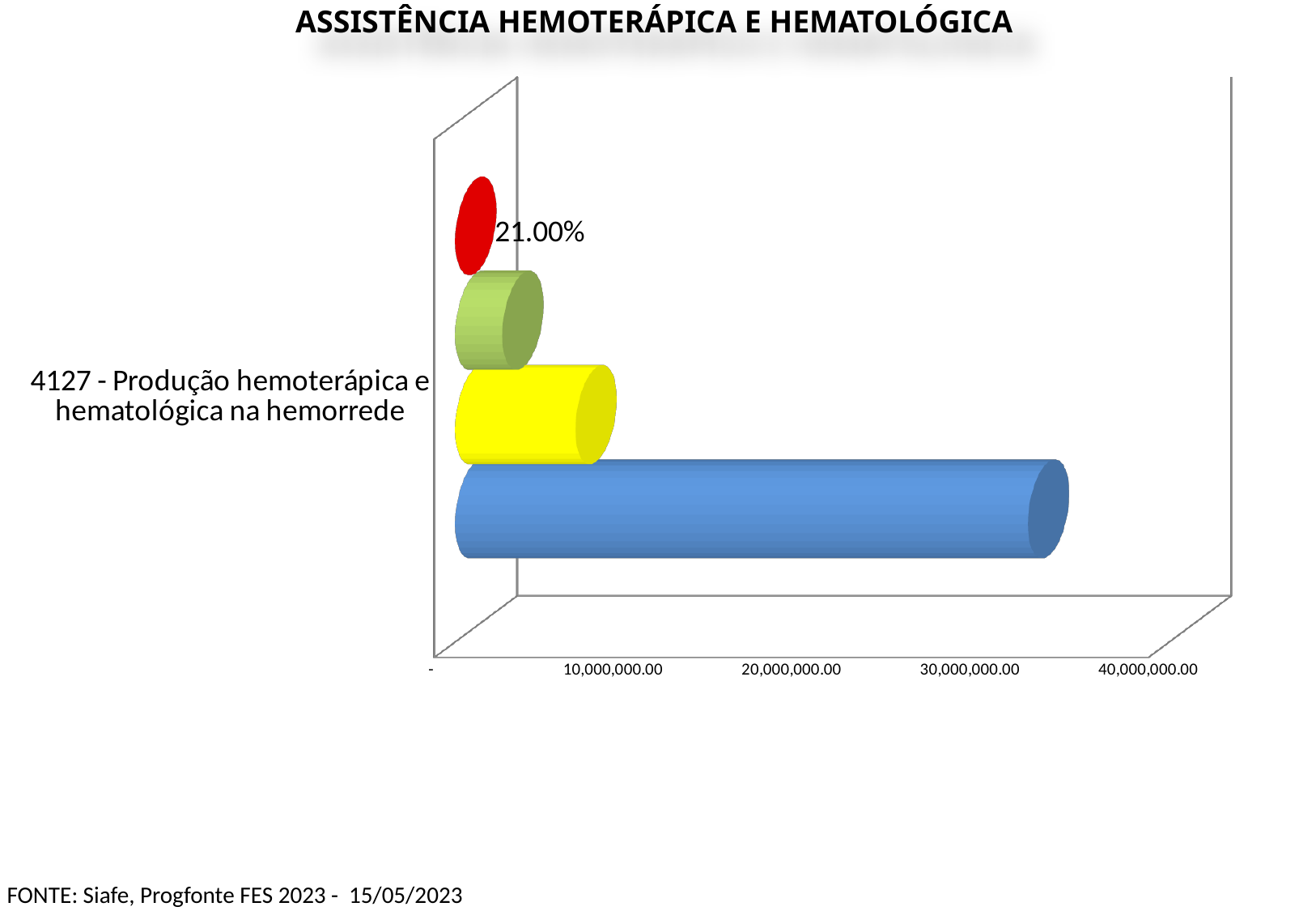
Which coloured bar is the shortest in the chart? red How many bars are plotted for the category '4127 - Produção hemoterápica e hematológica na hemorrede'? 4 Is the value of the yellow bar greater or less than 10,000,000.00? less What percentage is printed as a data label next to the red bar? 21.00% What kind of chart is shown on the slide? bar chart How many categories are shown on the vertical axis of the chart? 1 What is the highest tick value shown on the horizontal axis? 40,000,000.00 What is the title of the chart? ASSISTÊNCIA HEMOTERÁPICA E HEMATOLÓGICA Is the value of the blue bar greater or less than 30,000,000.00? greater Which coloured bar is the longest in the chart? blue What is the category label shown on the chart? 4127 - Produção hemoterápica e hematológica na hemorrede Which is larger, the value of the blue bar or the value of the yellow bar? blue bar